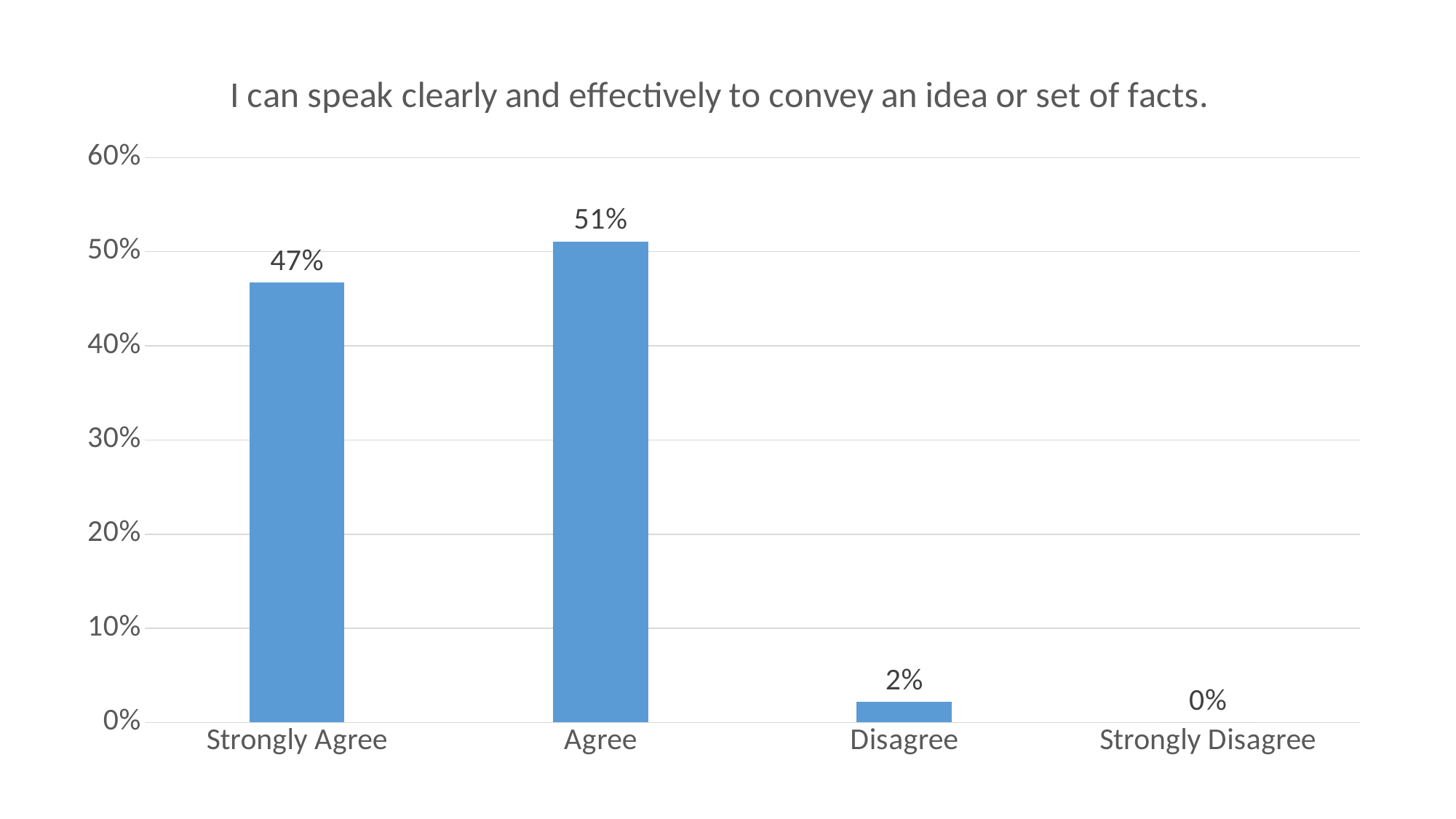
What is the title of the chart? I can speak clearly and effectively to convey an idea or set of facts. Which category has the lowest value? Strongly Disagree Which category has the highest value? Agree What is the value for Agree? 51% Is the value for Strongly Agree greater or less than 40%? greater How many categories are shown on the x axis? 4 What kind of chart is shown on the slide? bar chart What is the value for Disagree? 2% Which is larger, the value for Strongly Agree or the value for Disagree? Strongly Agree What is the value for Strongly Disagree? 0% What is the difference between the values for Agree and Strongly Agree? 4% What is the value for Strongly Agree? 47%